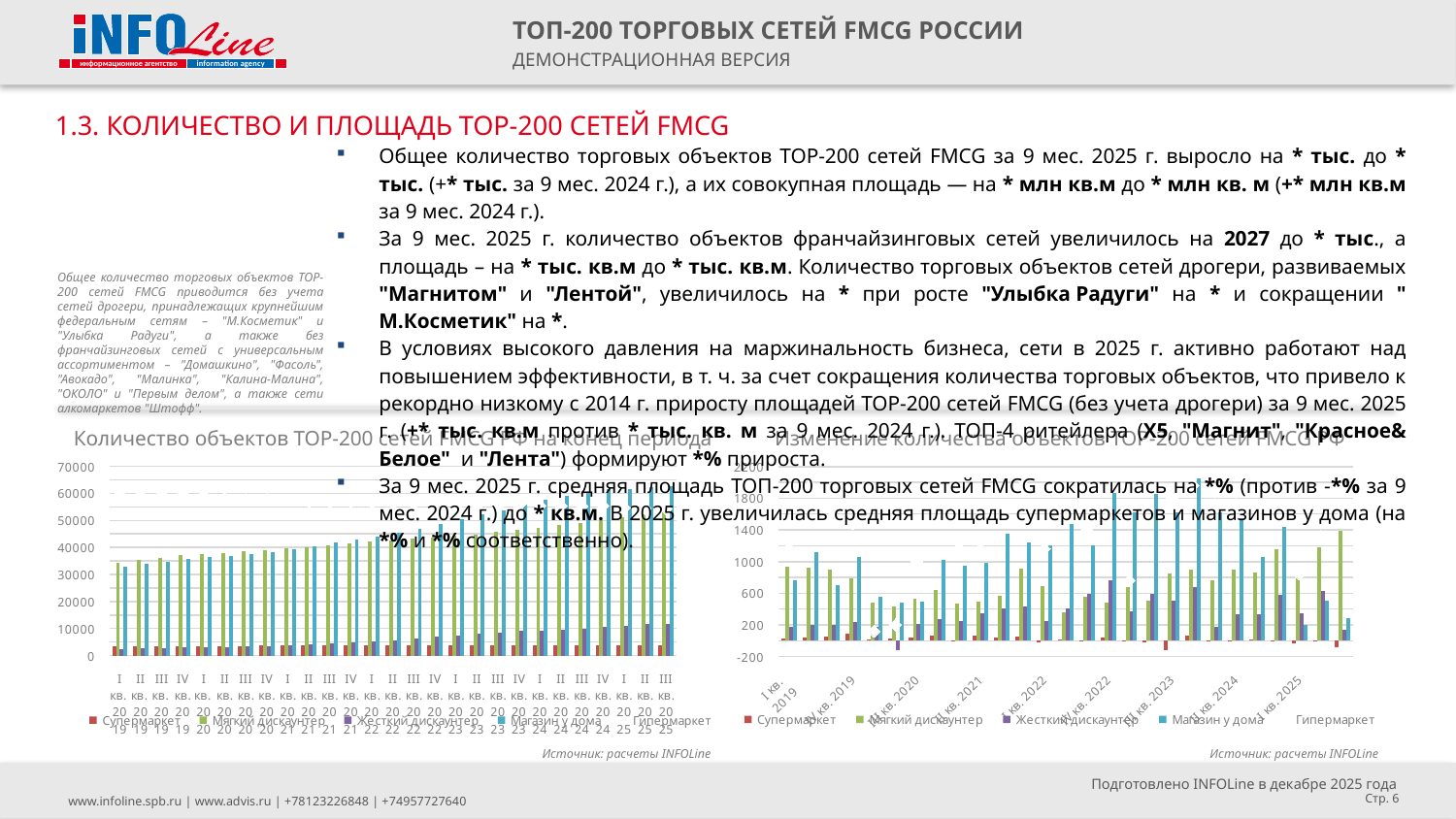
What is the source cited below the left chart (Количество объектов ТОР-200 сетей FMCG РФ на конец периода)? Источник: расчеты INFOLine In the right chart (Изменение количества объектов ТОР-200 сетей FMCG РФ), how many series does the legend list? 5 In the left chart (Количество объектов ТОР-200 сетей FMCG РФ на конец периода), is the value for Магазин у дома in I кв. 2019 greater or less than 40000? less In the left chart (Количество объектов ТОР-200 сетей FMCG РФ на конец периода), do the values for Магазин у дома rise or fall from I кв. 2019 to III кв. 2025? rise What kind of chart is the right chart titled "Изменение количества объектов ТОР-200 сетей FMCG РФ"? combination bar and line chart In the left chart (Количество объектов ТОР-200 сетей FMCG РФ на конец периода), how many series does the legend list? 5 In the left chart (Количество объектов ТОР-200 сетей FMCG РФ на конец периода), is the value for Магазин у дома in III кв. 2025 greater or less than 50000? greater In the left chart (Количество объектов ТОР-200 сетей FMCG РФ на конец периода), is the value for Супермаркет in III кв. 2025 greater or less than 10000? less In the left chart (Количество объектов ТОР-200 сетей FMCG РФ на конец периода), which series has the highest values? Магазин у дома What kind of chart is the left chart titled "Количество объектов ТОР-200 сетей FMCG РФ на конец периода"? combination bar and line chart How many quarterly periods are shown on the x axis of the left chart (Количество объектов ТОР-200 сетей FMCG РФ на конец периода)? 27 In the left chart (Количество объектов ТОР-200 сетей FMCG РФ на конец периода), which is larger in III кв. 2025: Магазин у дома or Мягкий дискаунтер? Магазин у дома